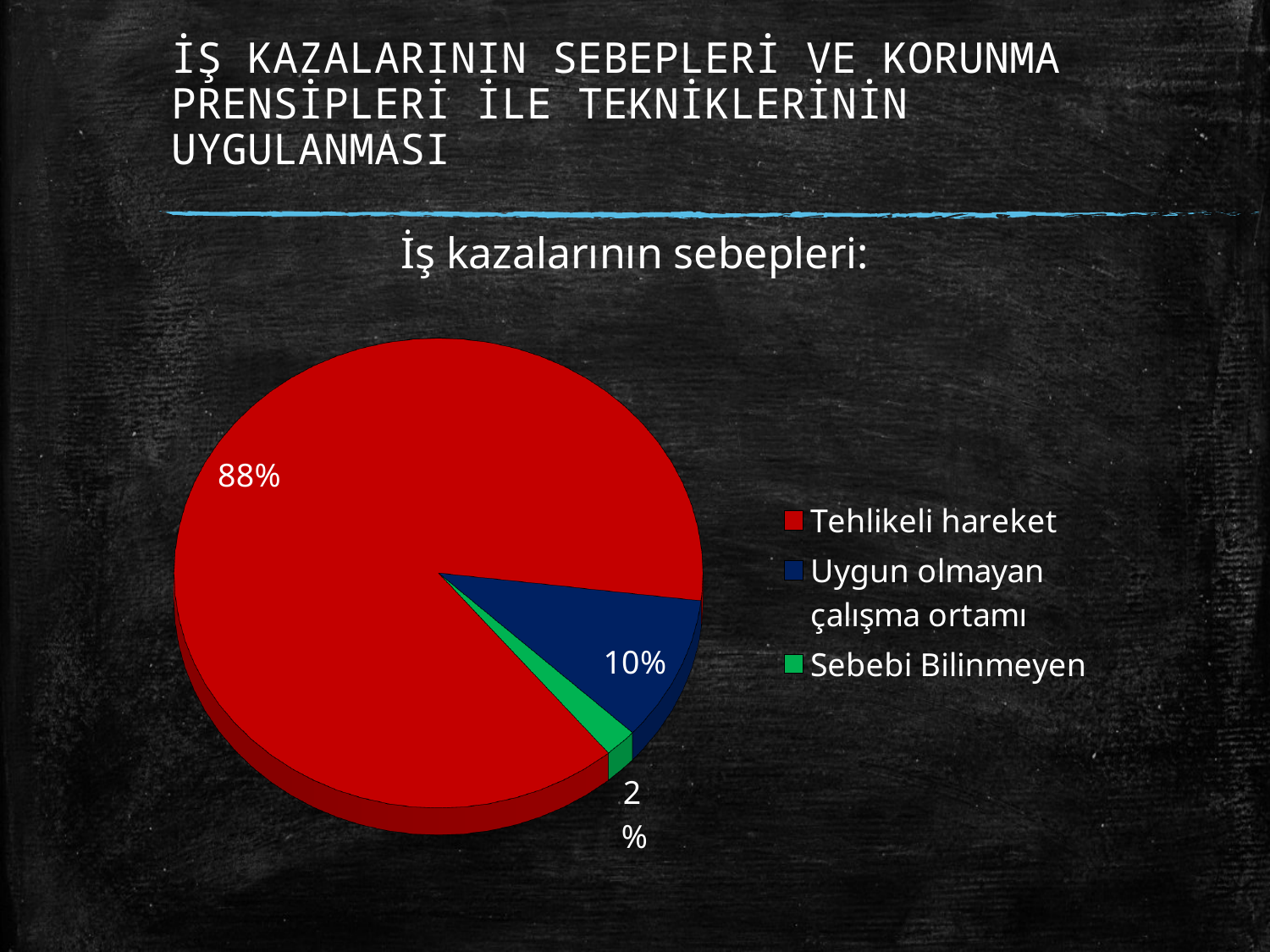
Which category has the smallest slice of the pie? Sebebi Bilinmeyen What colour is the slice for Tehlikeli hareket? red How many categories does the pie chart have? 3 Which category has the largest slice of the pie? Tehlikeli hareket What share of the pie does Tehlikeli hareket have? 88% What is the difference in percentage points between Uygun olmayan çalışma ortamı and Sebebi Bilinmeyen? 8 What is the difference in percentage points between Tehlikeli hareket and Uygun olmayan çalışma ortamı? 78 What is the title shown above the pie chart? İş kazalarının sebepleri: What share of the pie does Uygun olmayan çalışma ortamı have? 10% What share of the pie does Sebebi Bilinmeyen have? 2% What kind of chart is shown on the slide? pie chart Which is larger, the slice for Uygun olmayan çalışma ortamı or the slice for Sebebi Bilinmeyen? Uygun olmayan çalışma ortamı